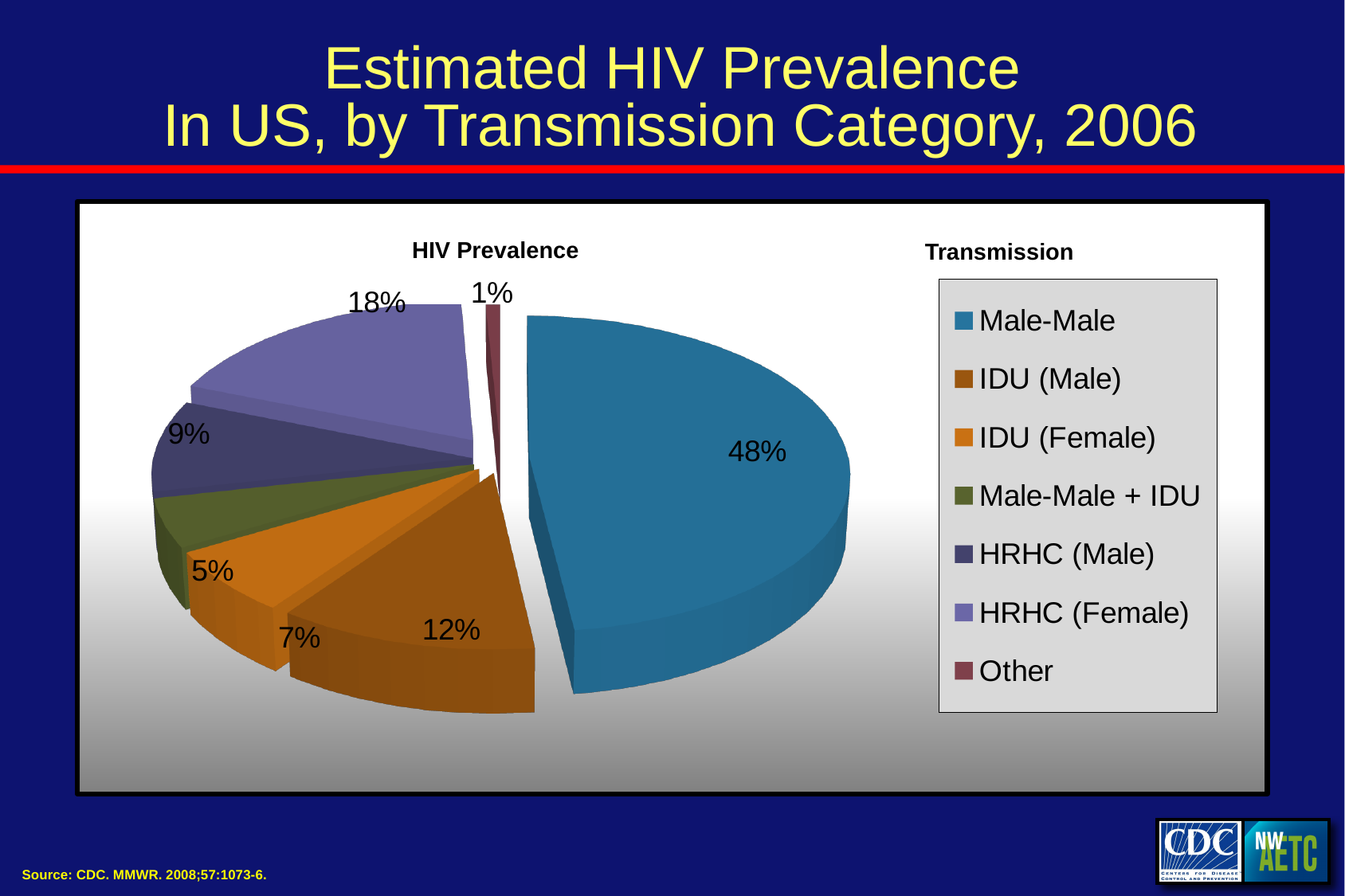
Which is larger, the share for IDU (Male) or the share for IDU (Female)? IDU (Male) What share of the pie does Male-Male transmission account for? 48% What kind of chart is shown on the slide? pie chart What is the value shown for HRHC (Male)? 9% What is the title of the legend on the chart? Transmission What is the value shown for Male-Male + IDU? 5% Which transmission category has the largest slice of the pie? Male-Male What is the difference between the Male-Male share and the HRHC (Female) share? 30% How many transmission categories are listed in the legend? 7 What is the value shown for IDU (Male)? 12% What is the value shown for HRHC (Female)? 18% Which transmission category has the smallest slice of the pie? Other